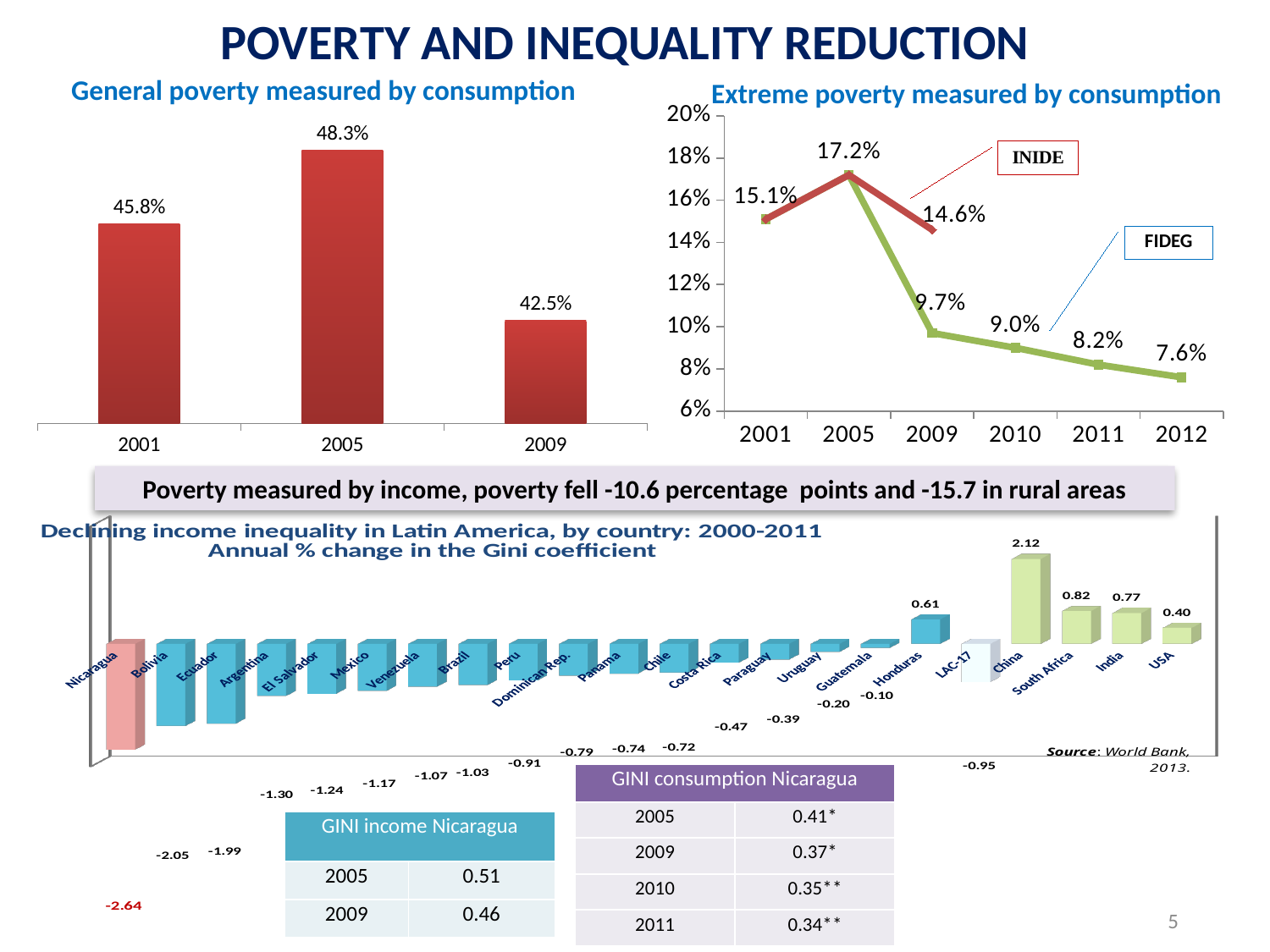
In the 'Extreme poverty measured by consumption' chart, do the FIDEG values rise or fall from 2009 to 2012? Fall What kind of chart is 'General poverty measured by consumption'? Bar chart In the 'General poverty measured by consumption' chart, what is the difference between the 2005 and 2009 values? 5.8 percentage points In the 'General poverty measured by consumption' chart, how many years are shown? 3 In the 'General poverty measured by consumption' chart, what is the value for 2005? 48.3% In the 'Extreme poverty measured by consumption' chart, how many series are shown? 2 In the 'General poverty measured by consumption' chart, which year has the lowest value? 2009 In the 'Declining income inequality in Latin America' chart, which country has the highest value? China In the 'Declining income inequality in Latin America' chart, what is the value for Nicaragua? -2.64 In the 'Extreme poverty measured by consumption' chart, what is the INIDE value for 2005? 17.2% In the 'Extreme poverty measured by consumption' chart, which is larger: the INIDE value for 2009 or the FIDEG value for 2009? INIDE (14.6%) In the 'Extreme poverty measured by consumption' chart, what is the FIDEG value for 2012? 7.6%